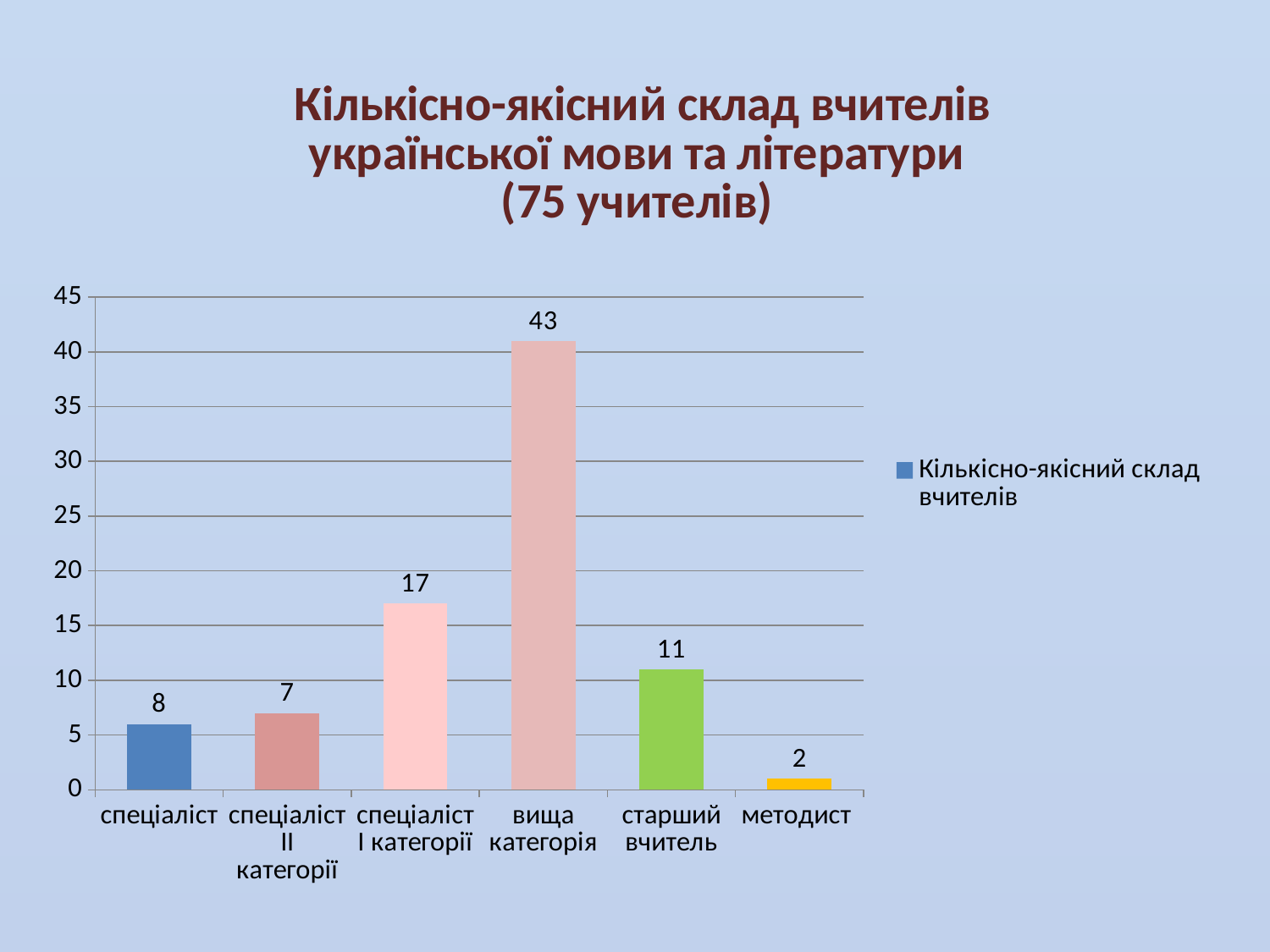
What is the difference between the values for "вища категорія" and "спеціаліст І категорії"? 26 Which category has the lowest value? методист Which is larger: the value for "старший вчитель" or the value for "спеціаліст"? старший вчитель Which category has the highest value? вища категорія What is the value shown for "спеціаліст І категорії"? 17 What is the value shown for "старший вчитель"? 11 How many categories are shown on the x axis? 6 What is the value shown for "методист"? 2 How many series does the legend list? 1 What is the value shown for "вища категорія"? 43 What is the legend entry for the series? Кількісно-якісний склад вчителів What kind of chart is shown on the slide? bar chart